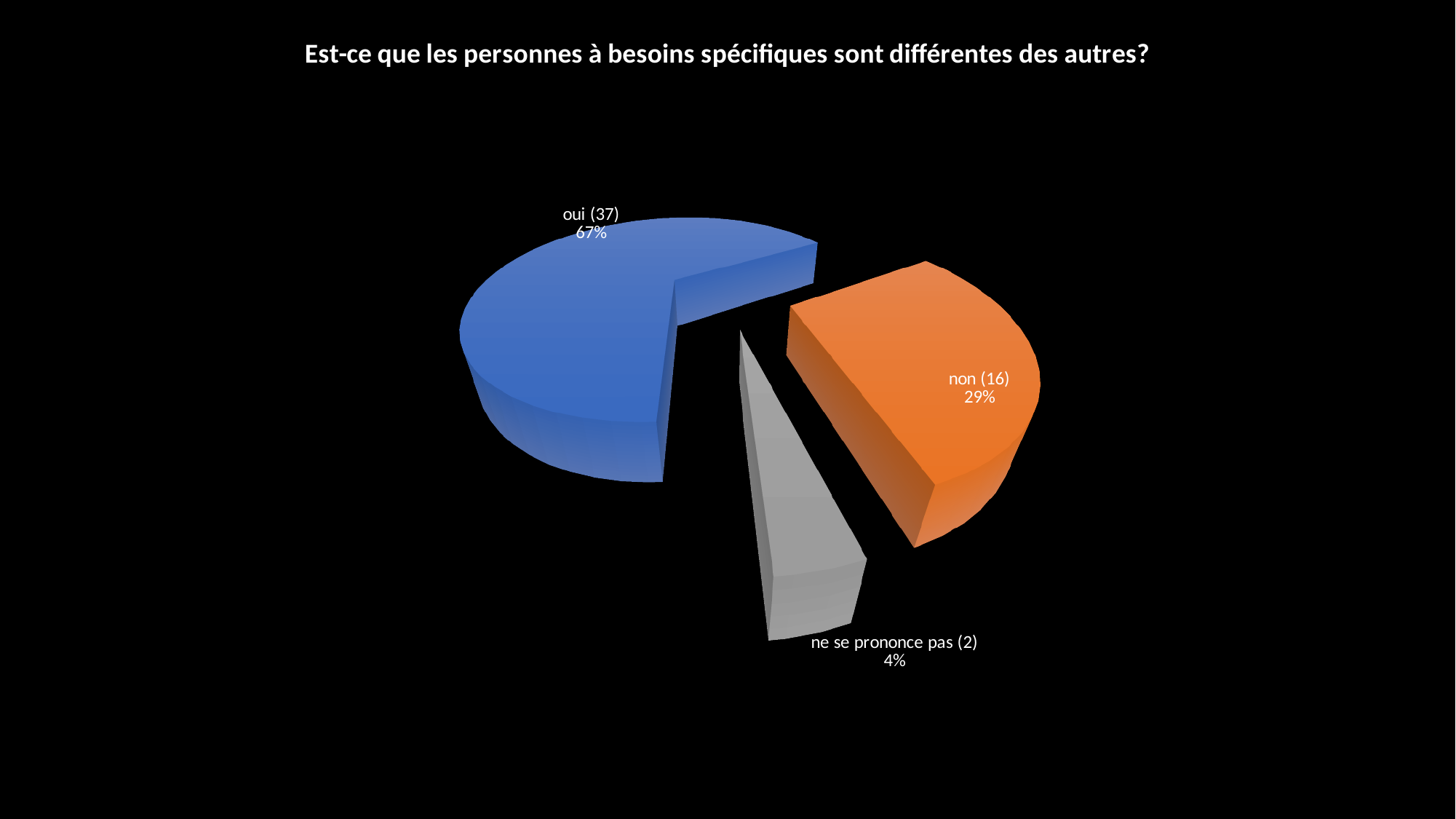
Which category has the largest slice of the pie? oui How many respondents answered "oui"? 37 What kind of chart is shown on the slide? pie chart How many respondents answered "non"? 16 How many slices does the pie chart have? 3 What percentage of the pie does the "ne se prononce pas" slice represent? 4% How many respondents are in the "ne se prononce pas" category? 2 What percentage of the pie does the "non" slice represent? 29% Which category has the smallest slice of the pie? ne se prononce pas What is the title of the chart? Est-ce que les personnes à besoins spécifiques sont différentes des autres? What percentage of the pie does the "oui" slice represent? 67% What is the difference in respondent count between "oui" and "non"? 21